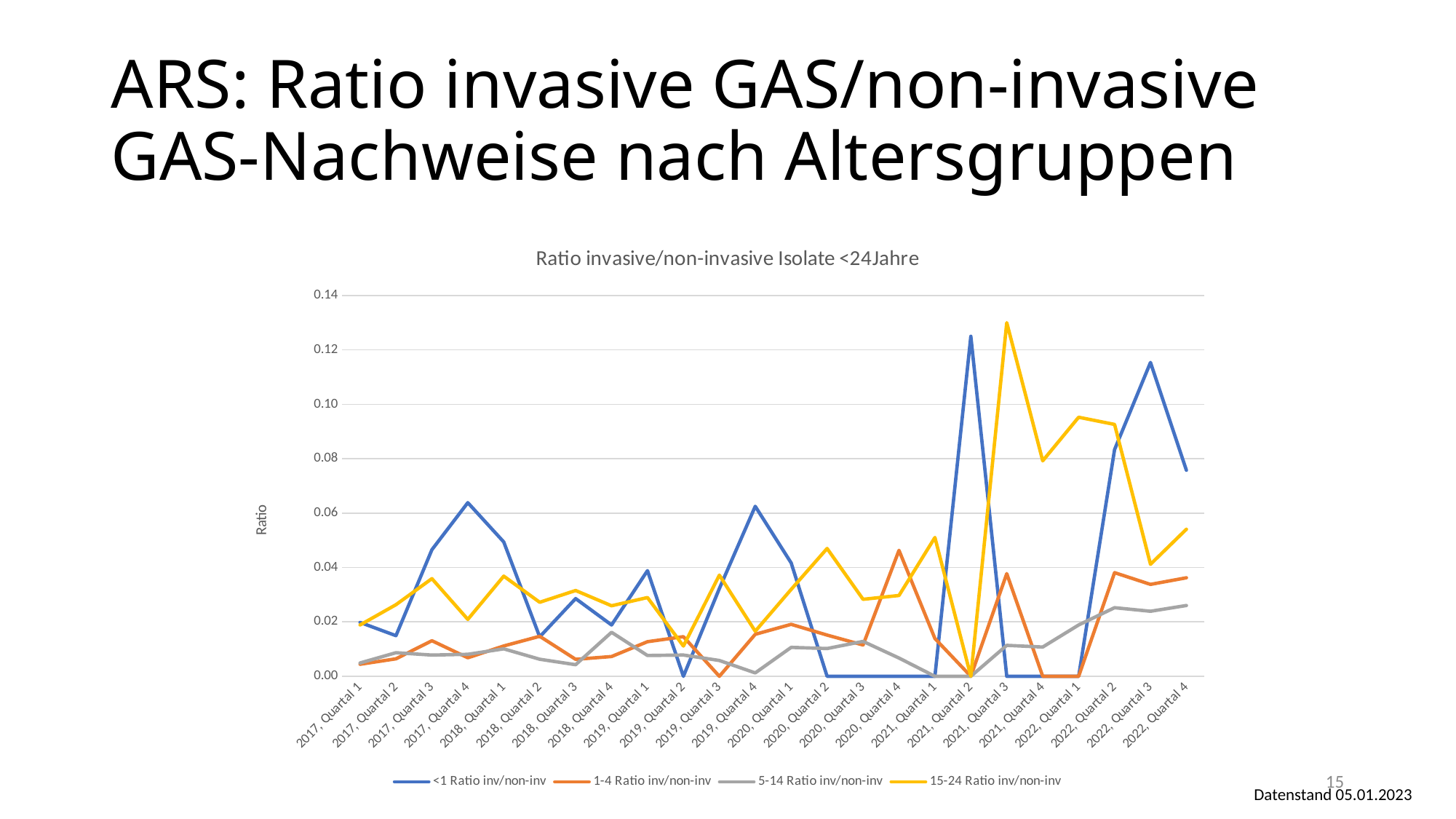
What is the title of the chart? Ratio invasive/non-invasive Isolate <24Jahre What is the label of the y axis? Ratio How many series does the legend list? 4 What is the value of the 15-24 Ratio inv/non-inv series at 2021, Quartal 2? 0.00 What kind of chart is shown on the slide? line chart Is the value of the <1 Ratio inv/non-inv series at 2022, Quartal 3 greater or less than 0.10? greater Is the value of the 15-24 Ratio inv/non-inv series at 2021, Quartal 3 greater or less than 0.12? greater Which series has the highest value at 2021, Quartal 3? 15-24 Ratio inv/non-inv What is the value of the <1 Ratio inv/non-inv series at 2019, Quartal 2? 0.00 How many quarters are plotted along the x axis? 24 Does the 5-14 Ratio inv/non-inv series rise or fall from 2021, Quartal 2 to 2022, Quartal 4? rise At 2022, Quartal 4, which is larger: the <1 Ratio inv/non-inv series or the 15-24 Ratio inv/non-inv series? <1 Ratio inv/non-inv